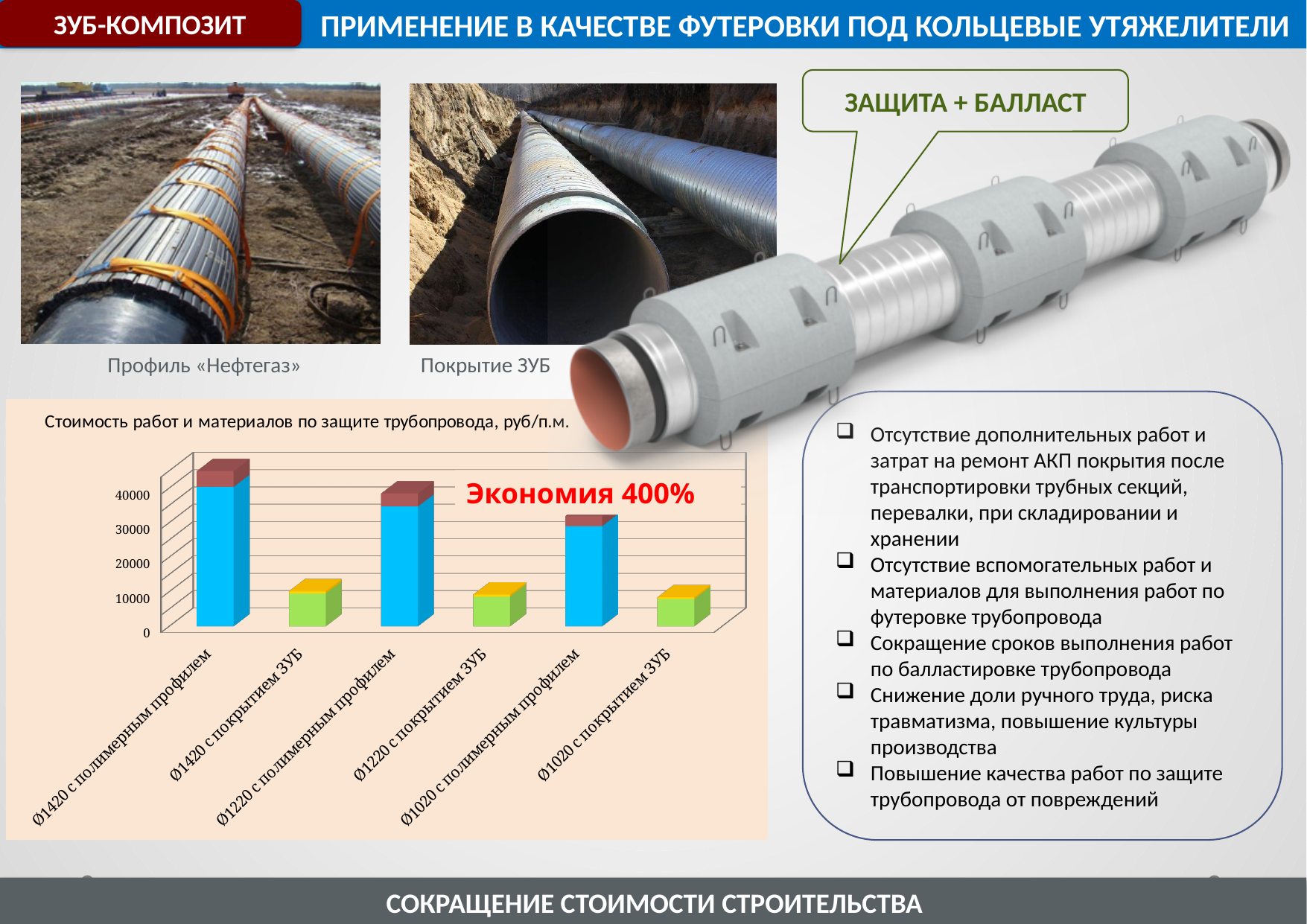
What is the title of the chart? Стоимость работ и материалов по защите трубопровода, руб/п.м. Which is larger: the value for Ø1420 с полимерным профилем or Ø1420 с покрытием ЗУБ? Ø1420 с полимерным профилем Which is larger: the value for Ø1220 с полимерным профилем or Ø1020 с полимерным профилем? Ø1220 с полимерным профилем Which category has the highest value on the chart? Ø1420 с полимерным профилем Is the value for Ø1420 с покрытием ЗУБ greater or less than 20000? less Do the values for the 'с полимерным профилем' categories rise or fall from Ø1420 to Ø1020 along the x axis? fall Is the value for Ø1020 с полимерным профилем greater or less than 40000? less How many categories are plotted on the chart? 6 Is the value for Ø1220 с полимерным профилем greater or less than 20000? greater What kind of chart is shown on the slide? bar chart What savings figure is annotated on the chart? Экономия 400%